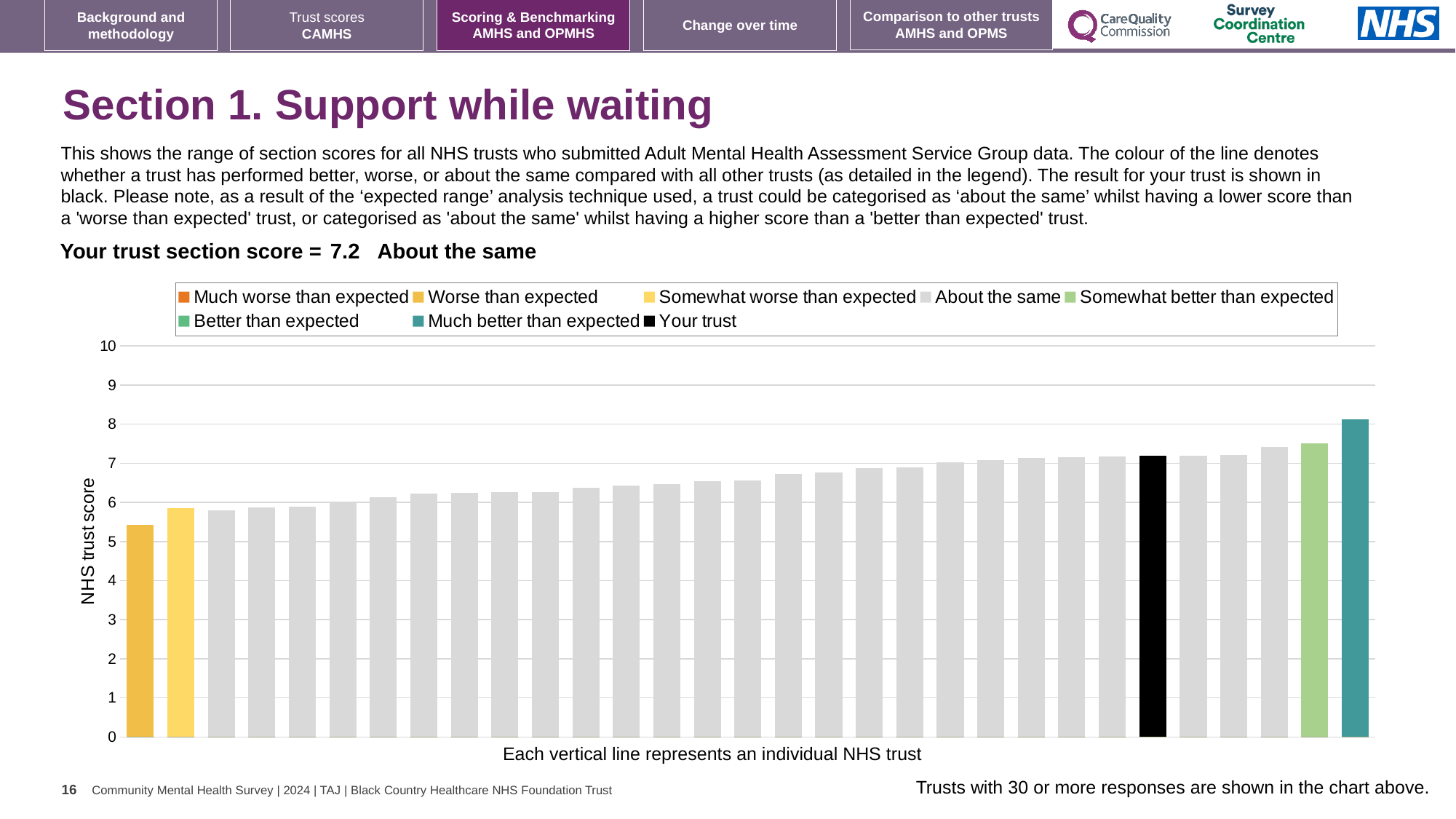
Is the value of the shortest bar greater or less than 6? less What is the label on the vertical axis of the chart? NHS trust score Is the value for your trust greater or less than 7? greater How is your trust's section score categorised compared with other trusts? About the same Which legend category does the shortest bar in the chart belong to? Worse than expected Which legend category does the tallest bar in the chart belong to? Much better than expected What colour is the bar representing your trust? black What is the section score for your trust shown on the slide? 7.2 What kind of chart is shown on the slide? bar chart How many entries does the chart legend list? 8 Do the bar values rise or fall from left to right across the chart? rise Which is larger: the value for your trust or the value of the rightmost bar? the rightmost bar